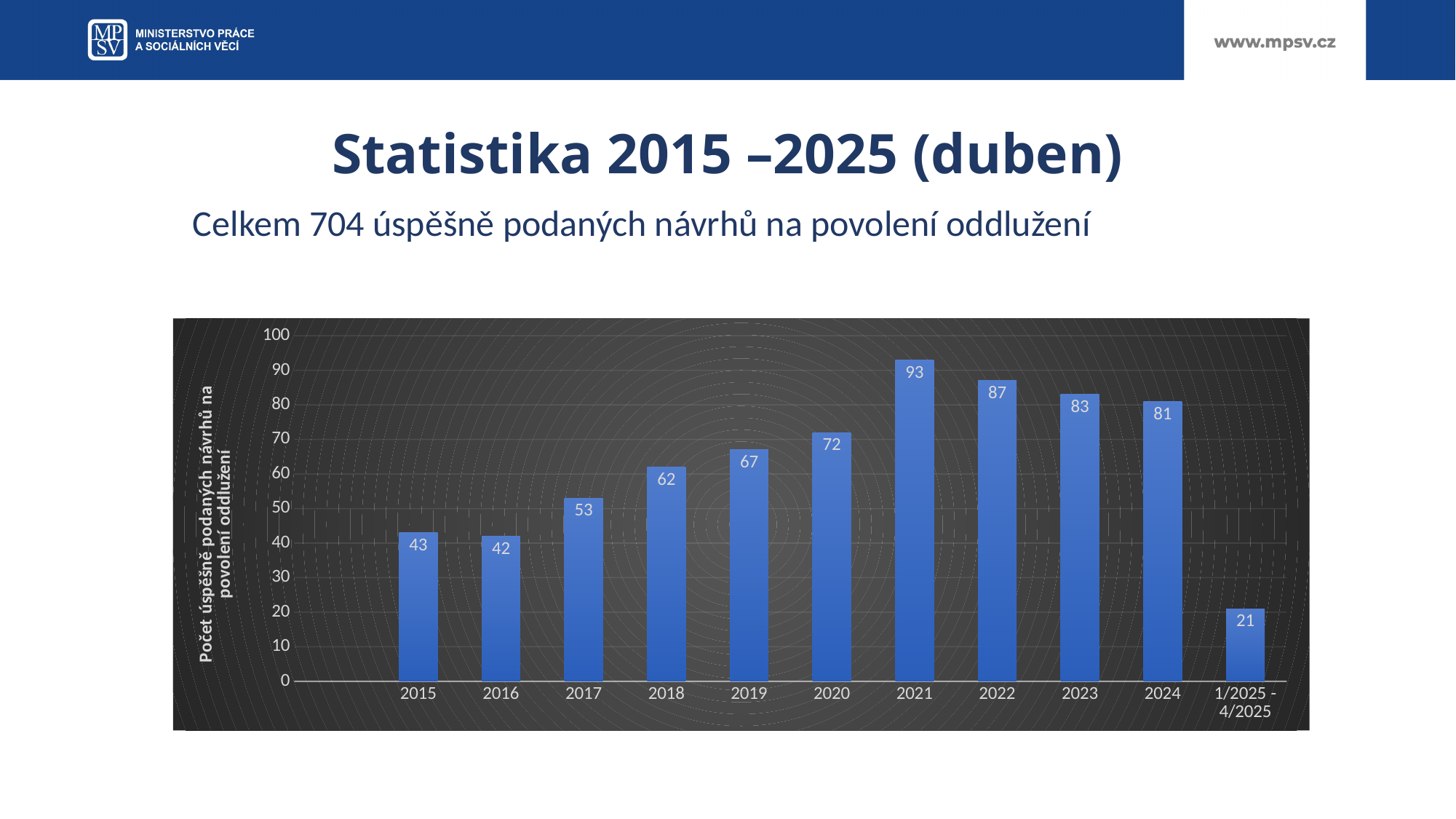
What kind of chart is shown on the slide? bar chart Which category has the highest value? 2021 What is the label of the vertical axis? Počet úspěšně podaných návrhů na povolení oddlužení What is the value for 2021? 93 Do the values rise or fall from 2016 to 2021? rise What is the value for 1/2025 - 4/2025? 21 What is the difference between the values for 2024 and 1/2025 - 4/2025? 60 How many categories are shown on the x axis? 11 Which is larger, the value for 2018 or the value for 2019? 2019 What is the difference between the values for 2021 and 2022? 6 Which category has the lowest value? 1/2025 - 4/2025 What is the value for 2015? 43